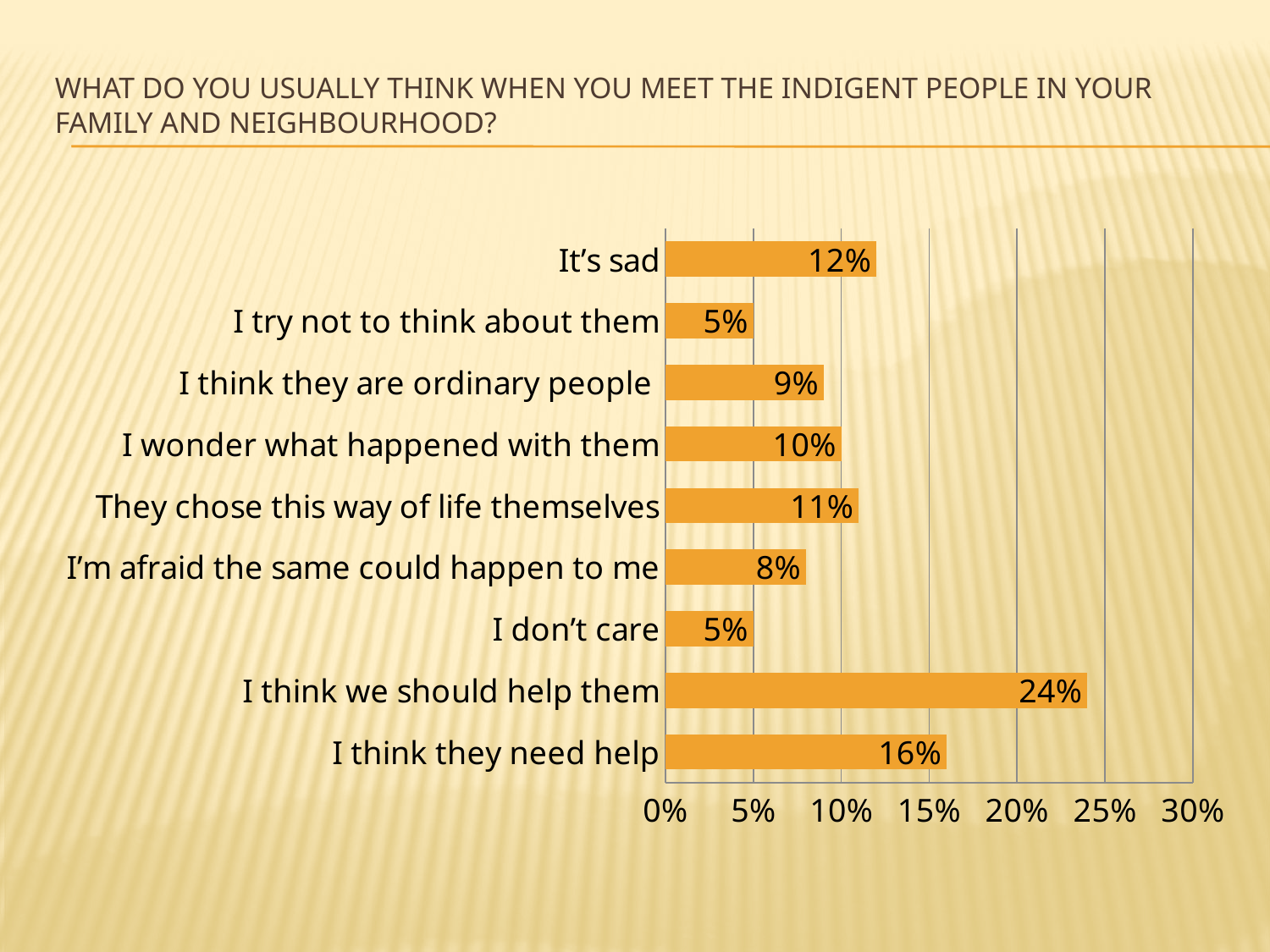
What kind of chart is shown on the slide? Bar chart How many categories are shown in the chart? 9 What is the highest value shown on the x axis? 30% What is the value for "They chose this way of life themselves"? 11% Which category has the highest value? I think we should help them What is the value for "I'm afraid the same could happen to me"? 8% What is the difference between "It's sad" and "I don't care"? 7% Is the value for "I think they need help" greater or less than 15%? greater Which is larger: "I think they are ordinary people" or "I wonder what happened with them"? I wonder what happened with them What is the value for "It's sad"? 12% What is the value for "I think we should help them"? 24% What is the difference between "I think we should help them" and "I think they need help"? 8%